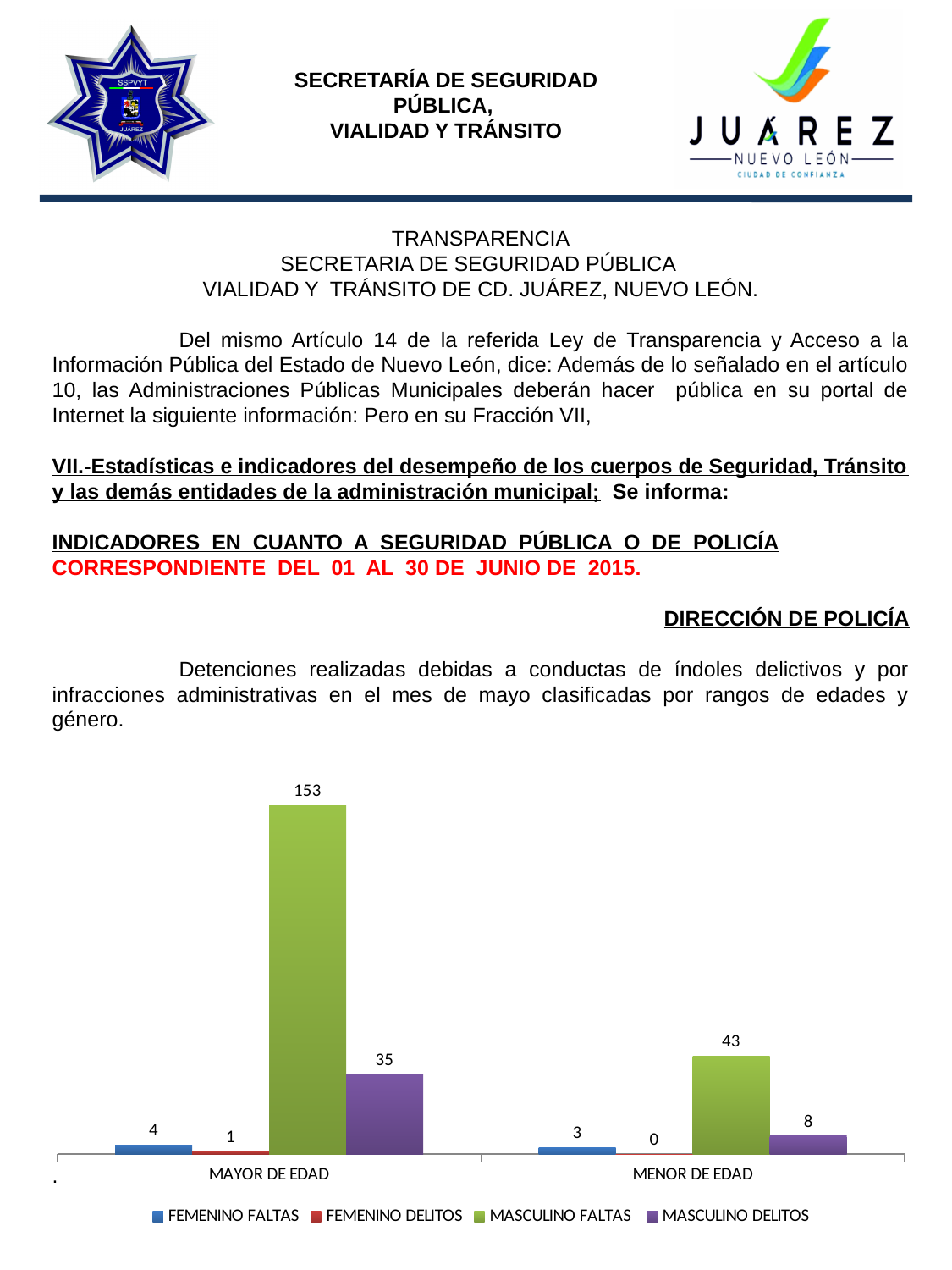
What is the difference between MASCULINO FALTAS for MAYOR DE EDAD and MASCULINO FALTAS for MENOR DE EDAD? 110 How many series does the chart legend list? 4 What is the value for MASCULINO FALTAS in the MAYOR DE EDAD category? 153 Which series has the highest value in the MENOR DE EDAD category? MASCULINO FALTAS Which series has the lowest value in the MAYOR DE EDAD category? FEMENINO DELITOS How many categories are shown on the x axis of the chart? 2 What is the value for FEMENINO DELITOS in the MENOR DE EDAD category? 0 What is the difference between MASCULINO DELITOS for MAYOR DE EDAD and MASCULINO DELITOS for MENOR DE EDAD? 27 Which is larger: FEMENINO FALTAS for MAYOR DE EDAD or FEMENINO FALTAS for MENOR DE EDAD? MAYOR DE EDAD What is the value for FEMENINO FALTAS in the MAYOR DE EDAD category? 4 What is the value for MASCULINO DELITOS in the MENOR DE EDAD category? 8 What kind of chart is shown on the slide? Bar chart